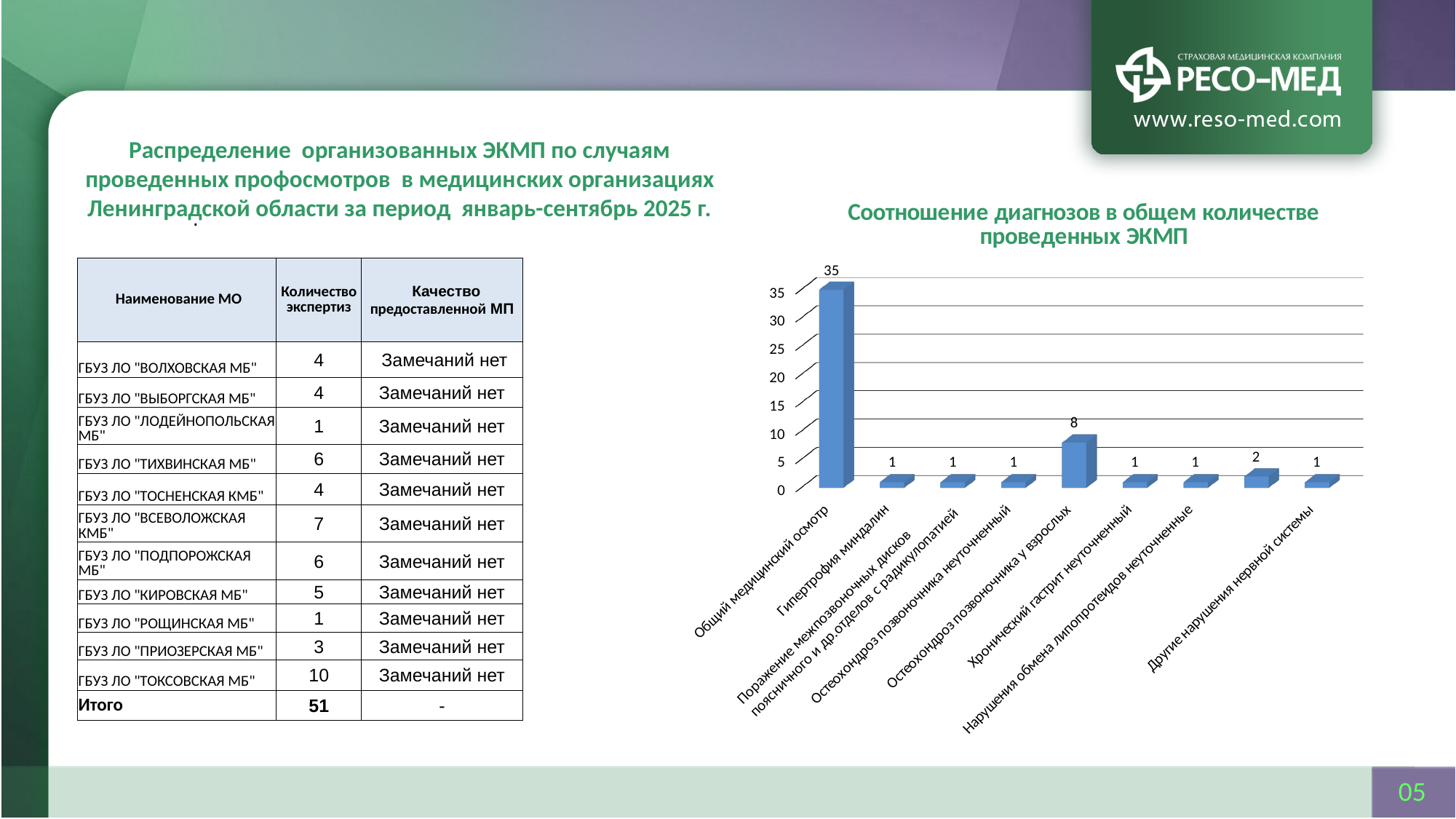
Is the value for Остеохондроз позвоночника у взрослых greater or less than 10? less Which category has the highest value in the chart? Общий медицинский осмотр What is the difference between the values for Общий медицинский осмотр and Остеохондроз позвоночника у взрослых? 27 Is the value for Общий медицинский осмотр greater or less than 30? greater What is the title of the chart? Соотношение диагнозов в общем количестве проведенных ЭКМП What kind of chart is shown on the slide? bar chart What is the value for Общий медицинский осмотр? 35 What is the value for Хронический гастрит неуточненный? 1 What is the value for Гипертрофия миндалин? 1 What is the value for Остеохондроз позвоночника у взрослых? 8 Which is larger: the value for Остеохондроз позвоночника у взрослых or the value for Остеохондроз позвоночника неуточненный? Остеохондроз позвоночника у взрослых How many bars are plotted in the chart? 9